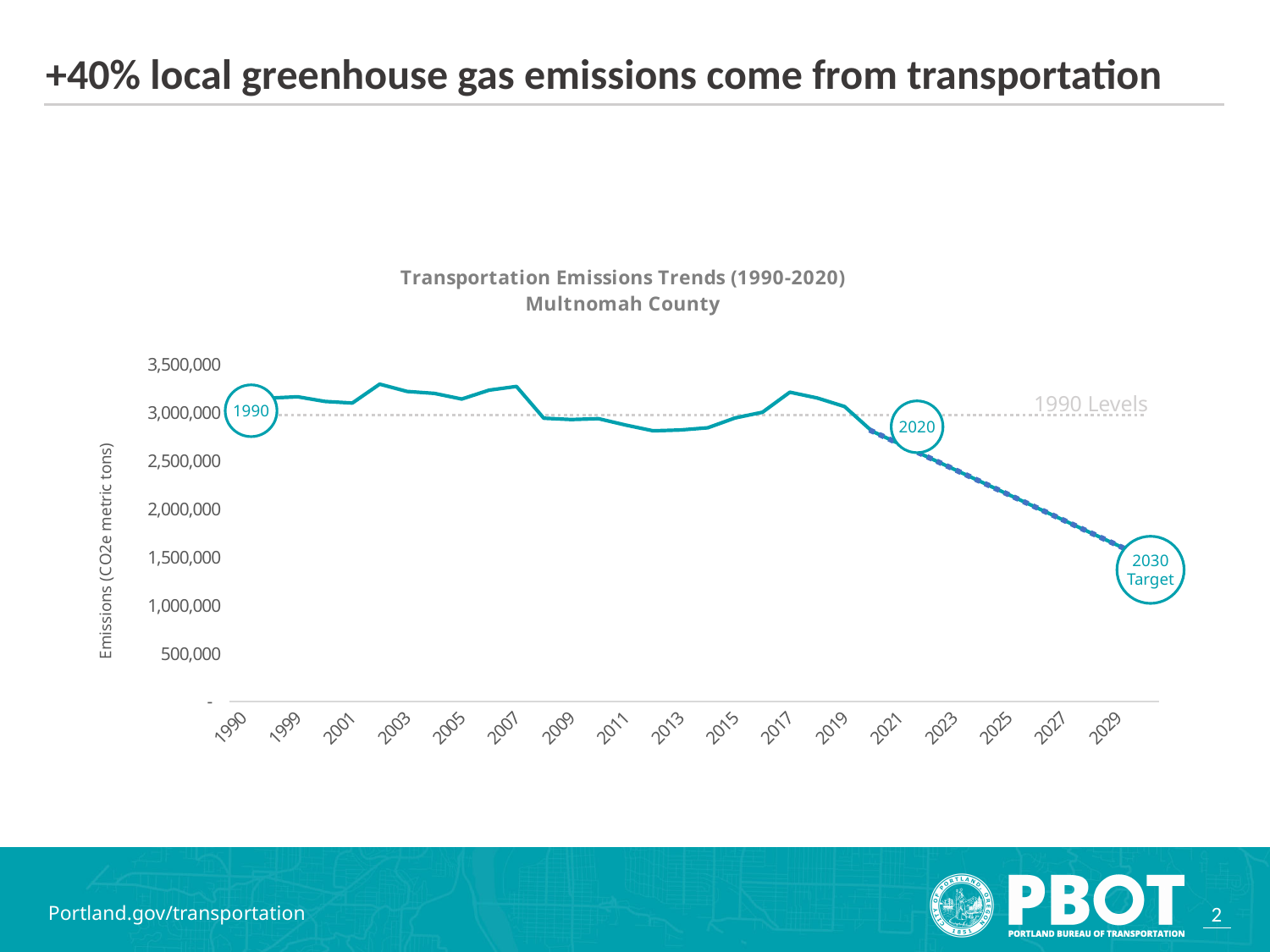
Do emissions rise or fall along the x axis from 2020 to the 2030 Target? fall Is the value for 2003 greater or less than 3,000,000? greater Is the value for the 2030 Target greater or less than 1,000,000? greater Which labeled point on the chart has the lowest emissions value? 2030 Target What kind of chart is shown on the slide? Line chart What label is given to the dashed horizontal reference line on the chart? 1990 Levels What is the title of the chart? Transportation Emissions Trends (1990-2020) Multnomah County Is the value for the 2030 Target greater or less than 2,000,000? less Which is larger, the value for 2020 or the value for the 2030 Target? 2020